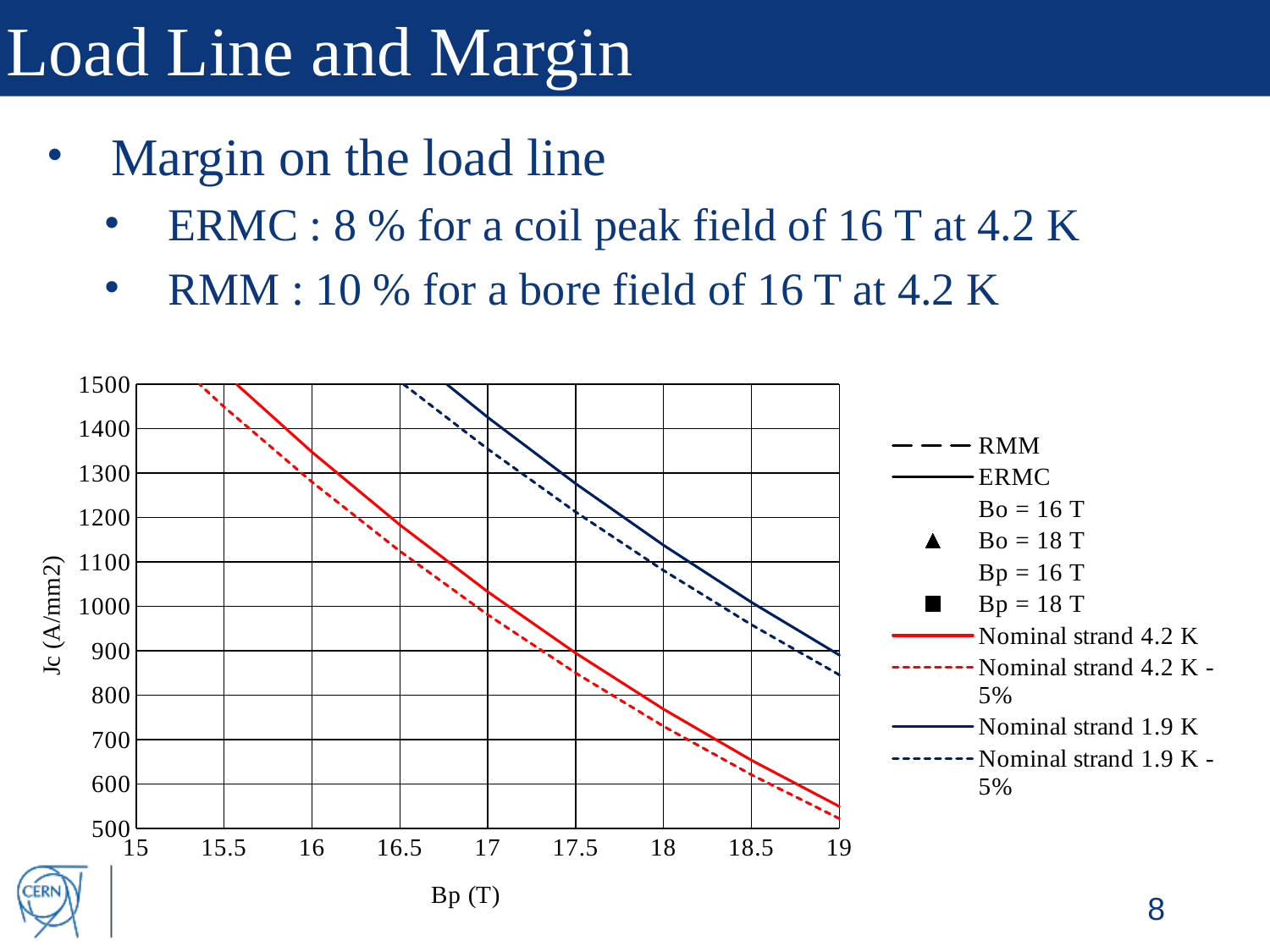
Do the Nominal strand 4.2 K values rise or fall as Bp increases? fall Do the Nominal strand 1.9 K values rise or fall as Bp increases? fall Is the Nominal strand 1.9 K value at Bp = 18 T greater or less than 1100? greater At Bp = 18 T, which is larger: the Nominal strand 1.9 K value or the Nominal strand 4.2 K value? Nominal strand 1.9 K What kind of chart is shown on the slide? line chart Is the Nominal strand 4.2 K value at Bp = 19 T greater or less than 600? less Is the Nominal strand 1.9 K value at Bp = 17 T greater or less than 1300? greater What is the label of the y axis of the chart? Jc (A/mm2) How many tick labels are shown on the x axis of the chart? 9 How many entries does the chart legend list? 10 What is the label of the x axis of the chart? Bp (T)